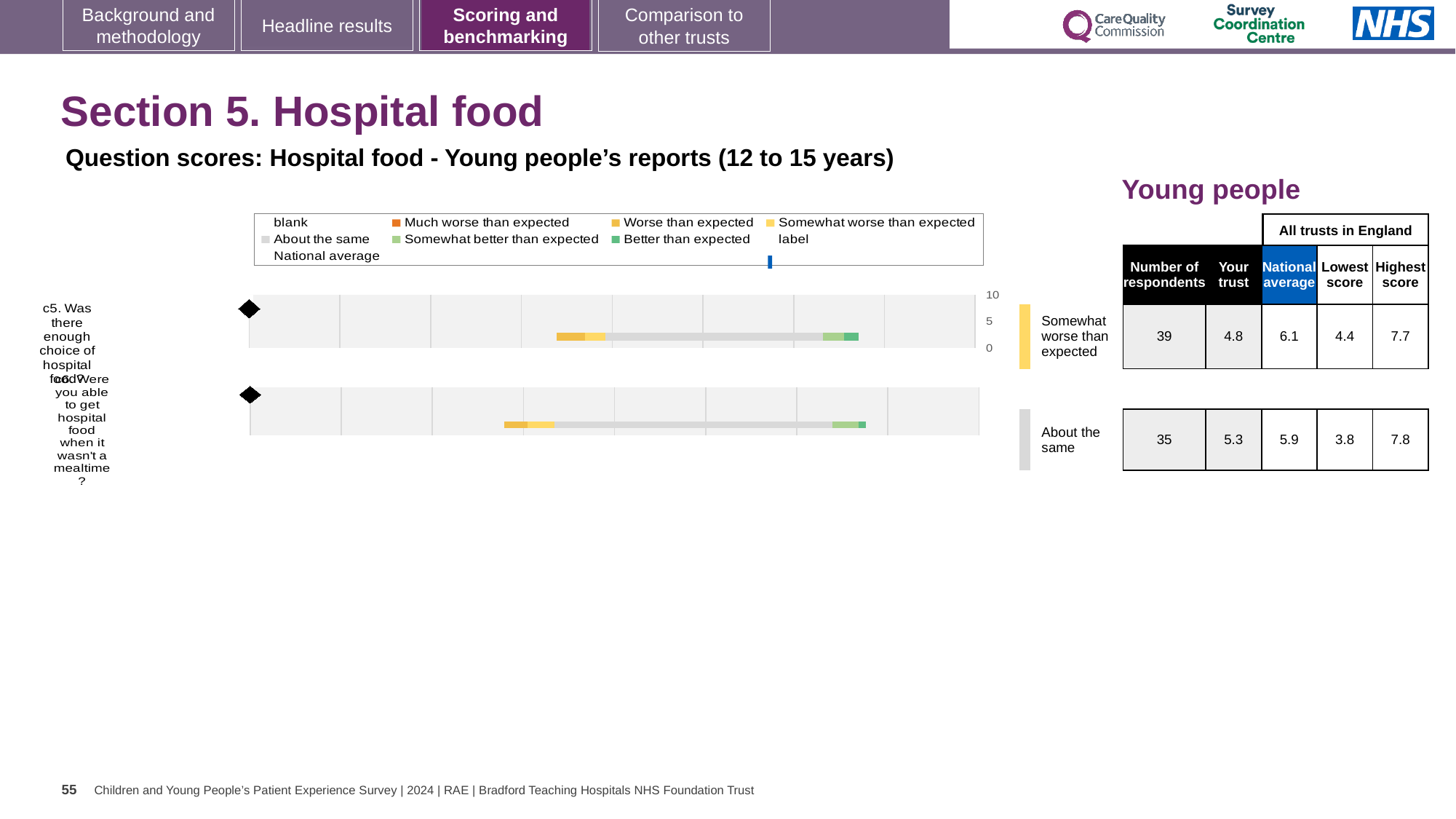
What is the difference between the national average and the trust's score for question c5? 1.3 How many respondents answered question c6? 35 Which is larger for question c5: the trust's score or the national average? national average What is the 'Your trust' score for question c6 (Were you able to get hospital food when it wasn't a mealtime?)? 5.3 What is the 'Your trust' score for question c5 (Was there enough choice of hospital food?)? 4.8 Which benchmark category is question c5 rated as? Somewhat worse than expected What kind of chart is shown on the slide? bar chart What is the highest score across all trusts in England for question c6? 7.8 How many questions (categories) are plotted in the chart? 2 What is the national average score for question c5 (Was there enough choice of hospital food?)? 6.1 What is the maximum value shown on the chart's score axis? 10 What is the lowest score across all trusts in England for question c5? 4.4